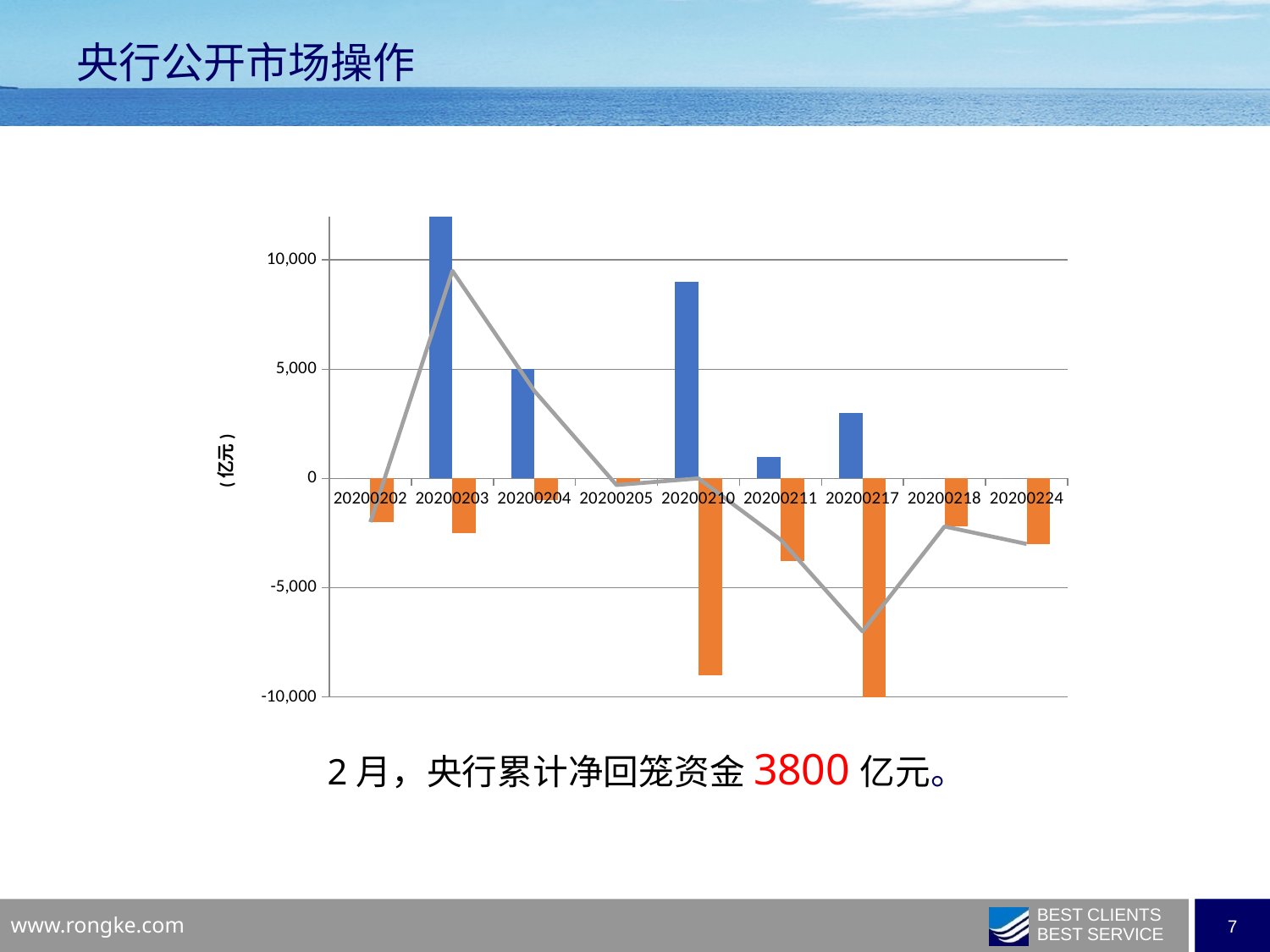
Which blue bar is larger, 20200204 or 20200210? 20200210 On which date does the orange bar reach the lowest value? 20200217 On which date is the blue bar the highest? 20200203 What unit is shown on the vertical axis label of the chart? 亿元 What kind of chart is shown on the slide? A bar chart combined with a line Is the orange bar for 20200210 greater or less than -5,000? less Does the grey line rise or fall from 20200203 to 20200217? fall What is the title of the chart on the slide? 央行公开市场操作 Is the blue bar for 20200203 greater or less than 10,000? greater Is the blue bar for 20200210 greater or less than 5,000? greater How many dates are shown on the x axis of the chart? 9